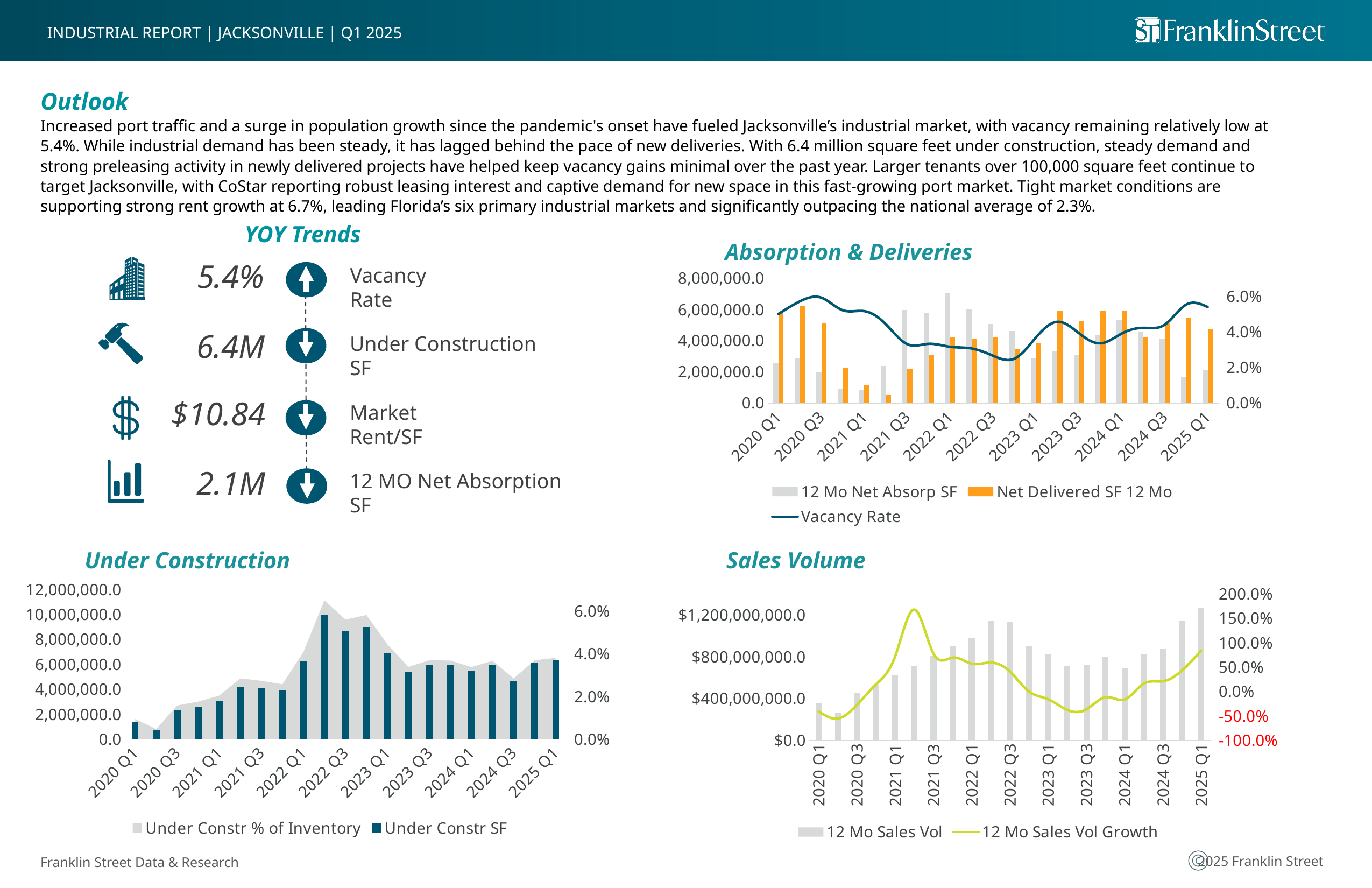
In the Sales Volume chart, which quarter has the highest 12 Mo Sales Vol bar? 2025 Q1 What kind of chart is the Under Construction chart? A bar chart with an area series (combo chart) How many series does the legend of the Absorption & Deliveries chart list? 3 In the Under Construction chart, which quarter has the highest Under Constr SF bar? 2022 Q2 In the Under Construction chart, is the Under Constr SF value for 2022 Q3 greater or less than 8,000,000.0? greater In the Absorption & Deliveries chart, what colour are the Net Delivered SF 12 Mo bars? Orange In the Sales Volume chart, is the 12 Mo Sales Vol Growth value for 2021 Q2 greater or less than 150.0%? greater In the Under Construction chart, which is larger, the Under Constr SF bar for 2022 Q3 or for 2025 Q1? 2022 Q3 How many series does the legend of the Sales Volume chart list? 2 In the Absorption & Deliveries chart, is the 12 Mo Net Absorp SF value for 2022 Q1 greater or less than 6,000,000.0? greater In the Under Construction chart, which quarter has the lowest Under Constr SF bar? 2020 Q2 In the Absorption & Deliveries chart, which quarter has the highest 12 Mo Net Absorp SF bar? 2022 Q1